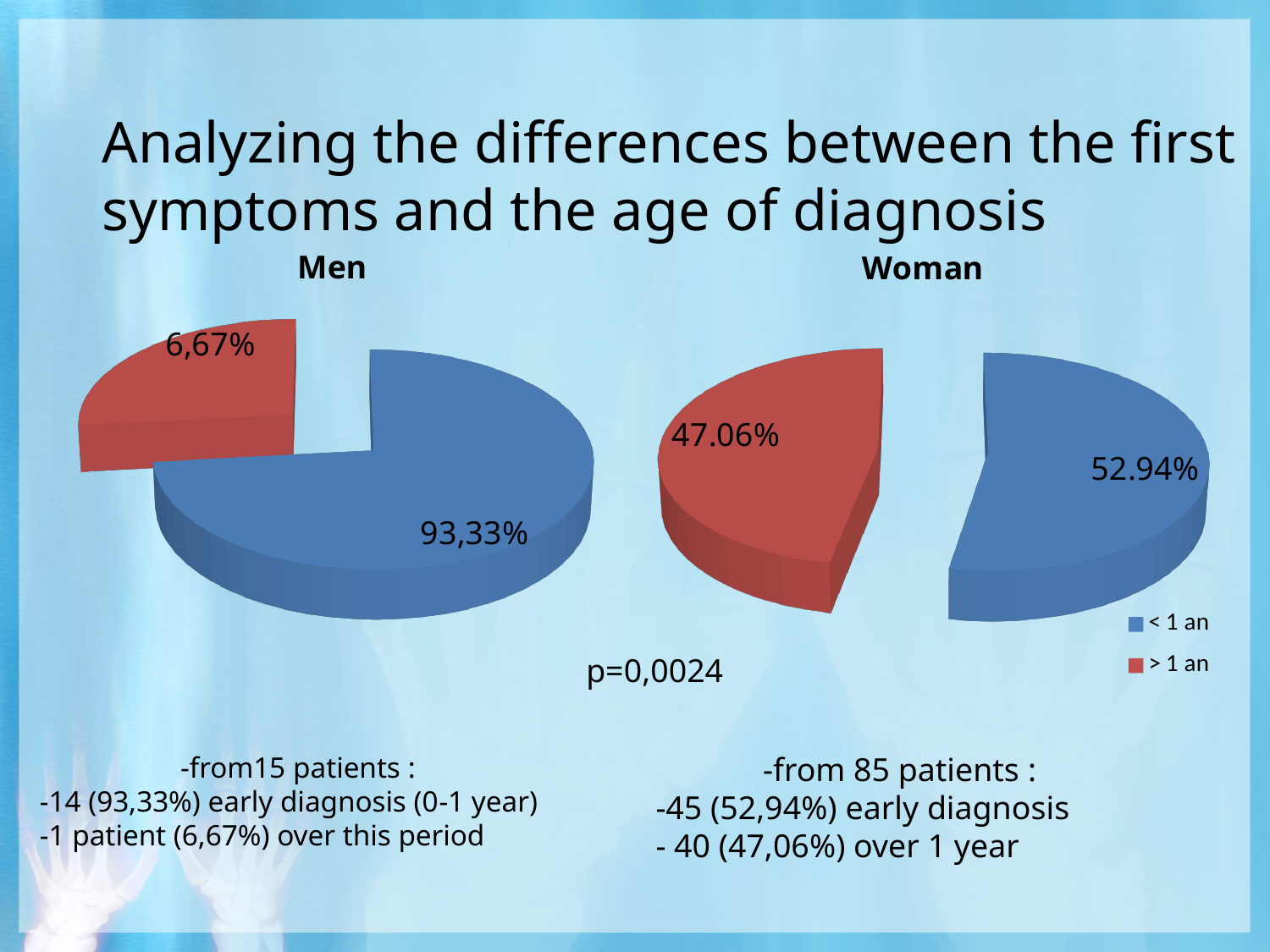
How many slices does the "Woman" chart have? 2 In the "Men" chart, what is the value for "< 1 an"? 93,33% In the "Woman" chart, what is the value for "> 1 an"? 47.06% What colour is the "> 1 an" slice in the legend? red What kind of chart is the "Men" chart? pie chart In the "Woman" chart, what is the value for "< 1 an"? 52.94% In the "Men" chart, what is the value for "> 1 an"? 6,67% In the "Woman" chart, what is the difference between the "< 1 an" and "> 1 an" slices? 5.88% In the "Men" chart, which category has the largest slice? < 1 an Which chart has the larger "> 1 an" slice, "Men" or "Woman"? Woman In the "Woman" chart, which category has the smallest slice? > 1 an In the "Men" chart, what is the difference between the "< 1 an" and "> 1 an" slices? 86,66%